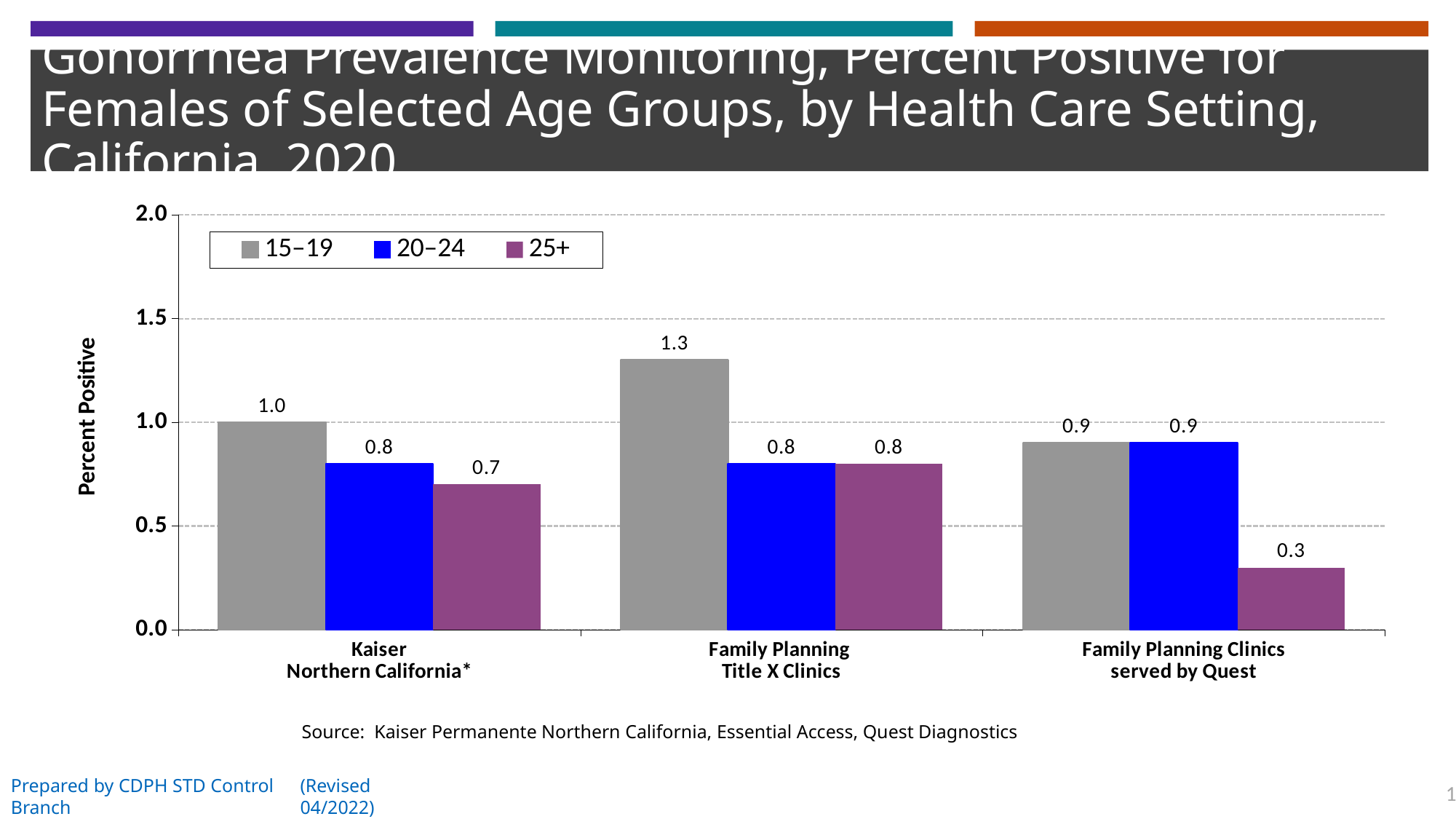
How many health care settings are shown on the x axis? 3 What is the difference between the percent positive for 15–19 at Family Planning Title X Clinics and at Family Planning Clinics served by Quest? 0.4 Which health care setting has the lowest percent positive for the 25+ age group? Family Planning Clinics served by Quest What kind of chart is shown on the slide? bar chart What is the percent positive for females aged 20–24 at Kaiser Northern California? 0.8 What is the percent positive for females aged 25+ at Family Planning Clinics served by Quest? 0.3 What is the difference between the percent positive for 15–19 and 25+ at Kaiser Northern California? 0.3 What is the percent positive for females aged 15–19 at Family Planning Title X Clinics? 1.3 Is the percent positive for 15–19 at Family Planning Title X Clinics greater or less than 1.0? greater Which is larger: the percent positive for 25+ at Family Planning Title X Clinics or at Family Planning Clinics served by Quest? Family Planning Title X Clinics How many age groups does the legend list? 3 Which health care setting has the highest percent positive for the 15–19 age group? Family Planning Title X Clinics